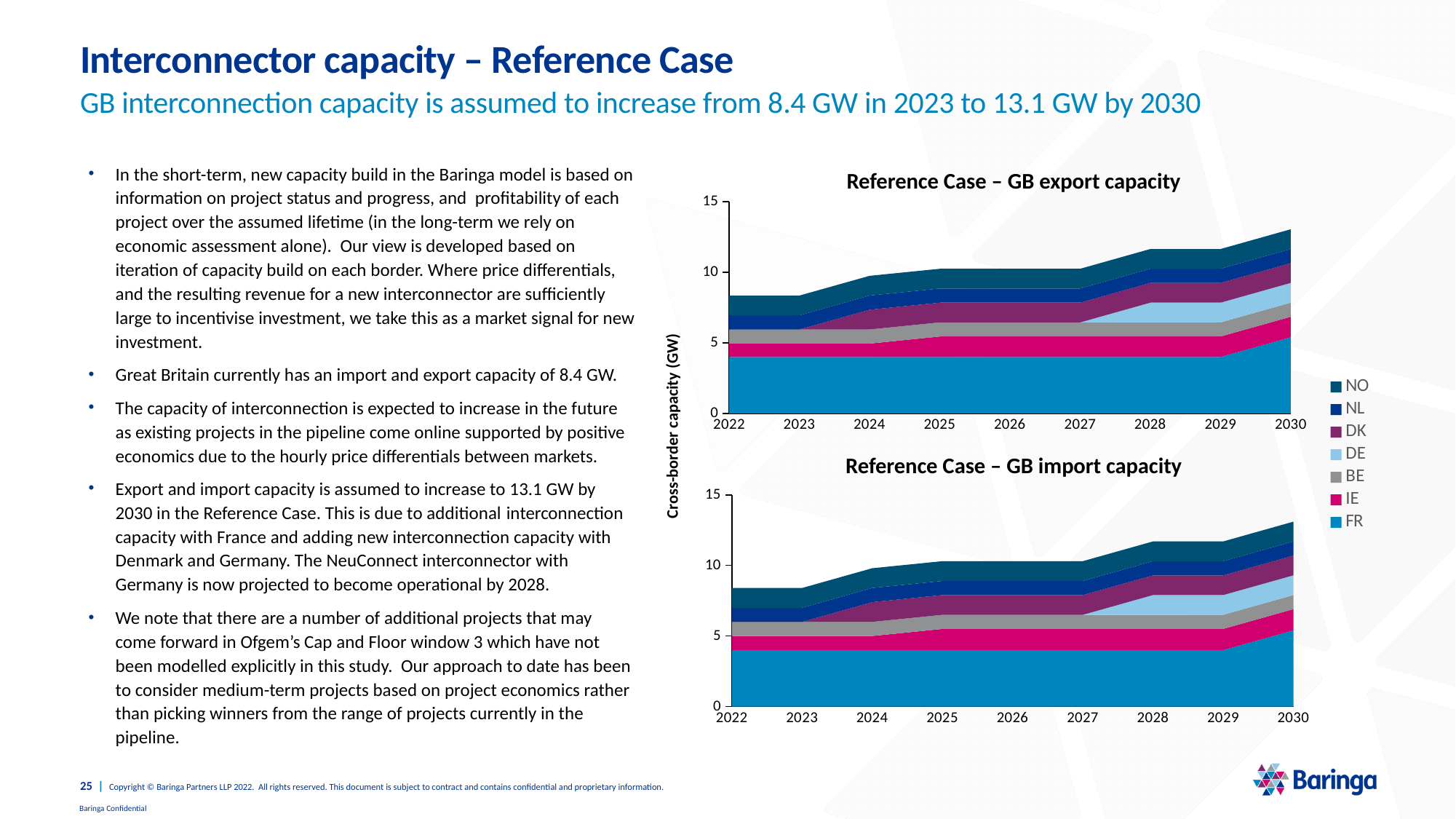
How many years are plotted along the x axis of the 'Reference Case – GB import capacity' chart? 9 In the 'Reference Case – GB export capacity' chart, does the total capacity rise or fall from 2022 to 2030? Rise In the 'Reference Case – GB export capacity' chart, is the total capacity in 2028 greater or less than 10? greater In the 'Reference Case – GB import capacity' chart, is the value for FR in 2022 greater or less than 5? less In the 'Reference Case – GB import capacity' chart, is the total capacity in 2030 greater or less than 10? greater What is the title of the lower chart on the slide? Reference Case – GB import capacity How many series does the legend list for the charts on the slide? 7 In the 'Reference Case – GB export capacity' chart, which series has the largest area in 2022? FR What kind of chart is the 'Reference Case – GB export capacity' chart? Stacked area chart In the 'Reference Case – GB import capacity' chart, which series first appears in 2028? DE What is the label of the shared y axis for the two charts? Cross-border capacity (GW)